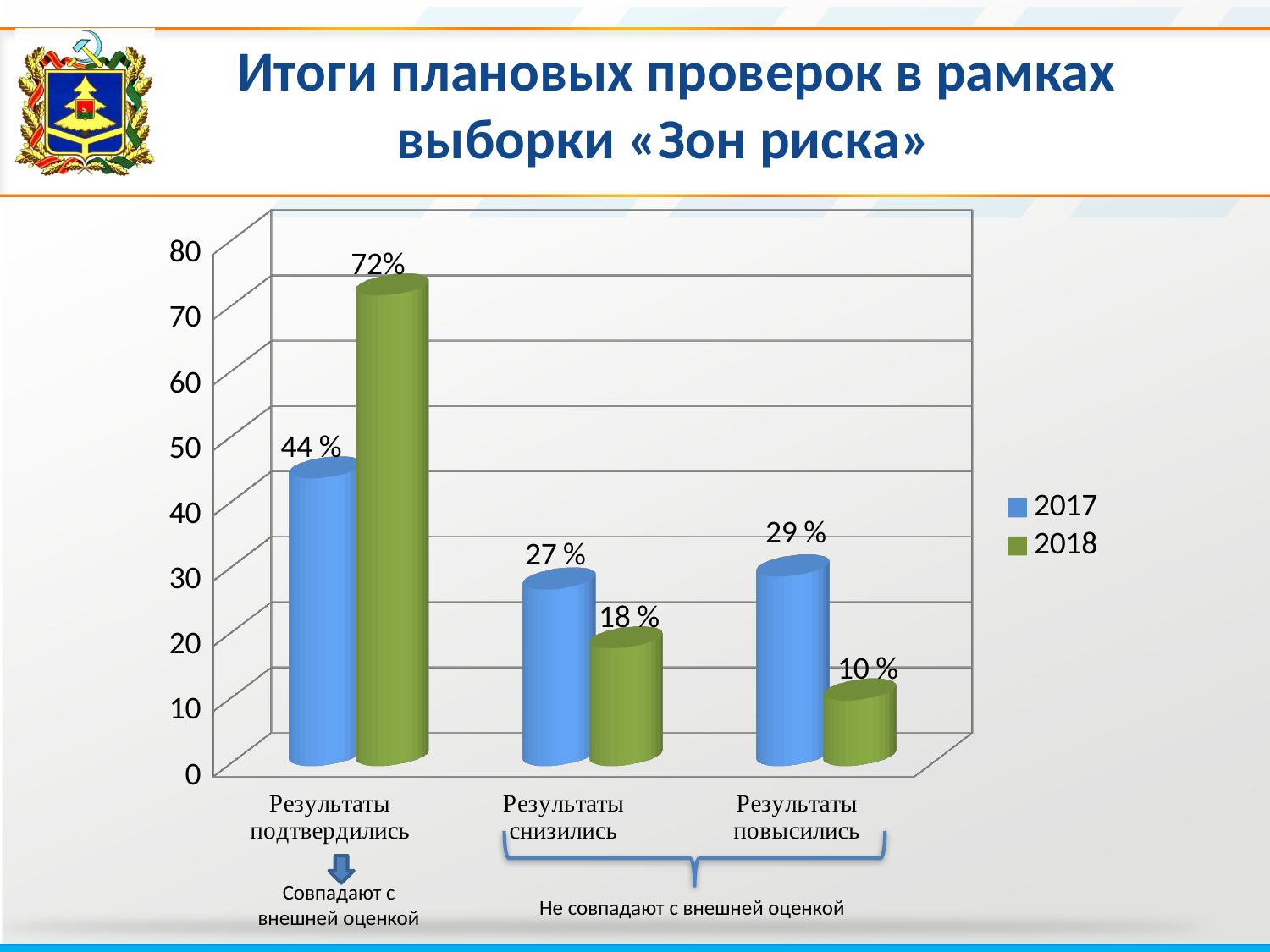
What kind of chart is shown on the slide? Bar chart What is the value for 2017 in the category «Результаты снизились»? 27 % How many categories are shown on the x axis? 3 Which is larger in the category «Результаты снизились»: the 2017 value or the 2018 value? 2017 What is the value for 2018 in the category «Результаты подтвердились»? 72% What is the value for 2018 in the category «Результаты повысились»? 10 % What is the difference between the 2017 and 2018 values in the category «Результаты повысились»? 19 Which category has the lowest value for the 2018 series? Результаты повысились What is the value for 2017 in the category «Результаты подтвердились»? 44 % Which category has the highest value for the 2018 series? Результаты подтвердились What is the difference between the 2018 and 2017 values in the category «Результаты подтвердились»? 28 How many series does the legend list? 2